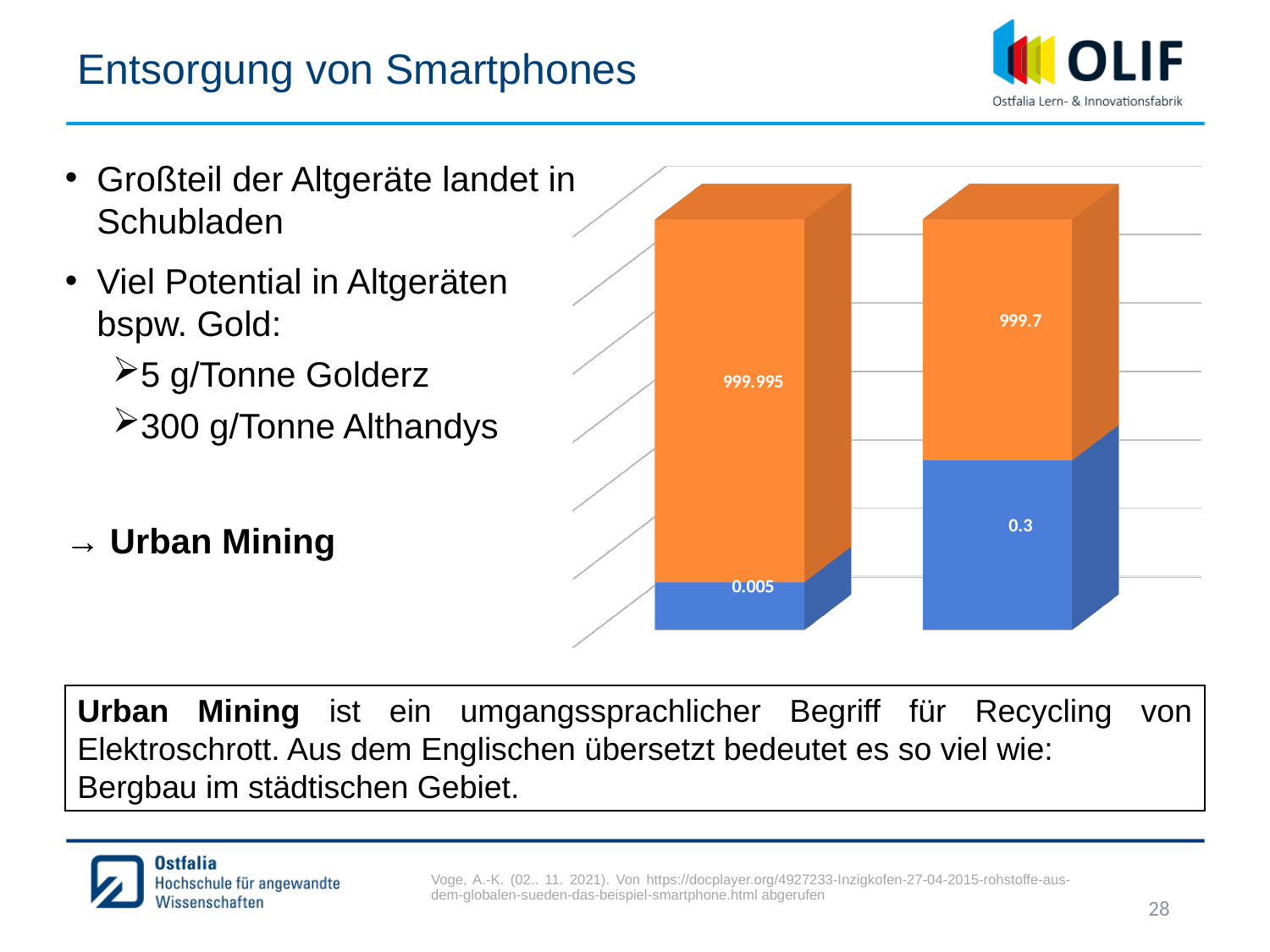
What is the total of the right stacked bar? 1000 What two colours are used for the segments of the stacked bars? blue and orange How many bars does the chart show? 2 What is the total of the left stacked bar? 1000 What kind of chart is shown on the slide? stacked bar chart What is the value of the blue segment of the right bar? 0.3 Which bar has the larger blue segment, the left or the right? right Which bar has the larger orange segment, the left or the right? left What is the difference between the blue segment of the right bar and the blue segment of the left bar? 0.295 What is the value of the orange segment of the left bar? 999.995 What is the value of the orange segment of the right bar? 999.7 What is the value of the blue segment of the left bar? 0.005